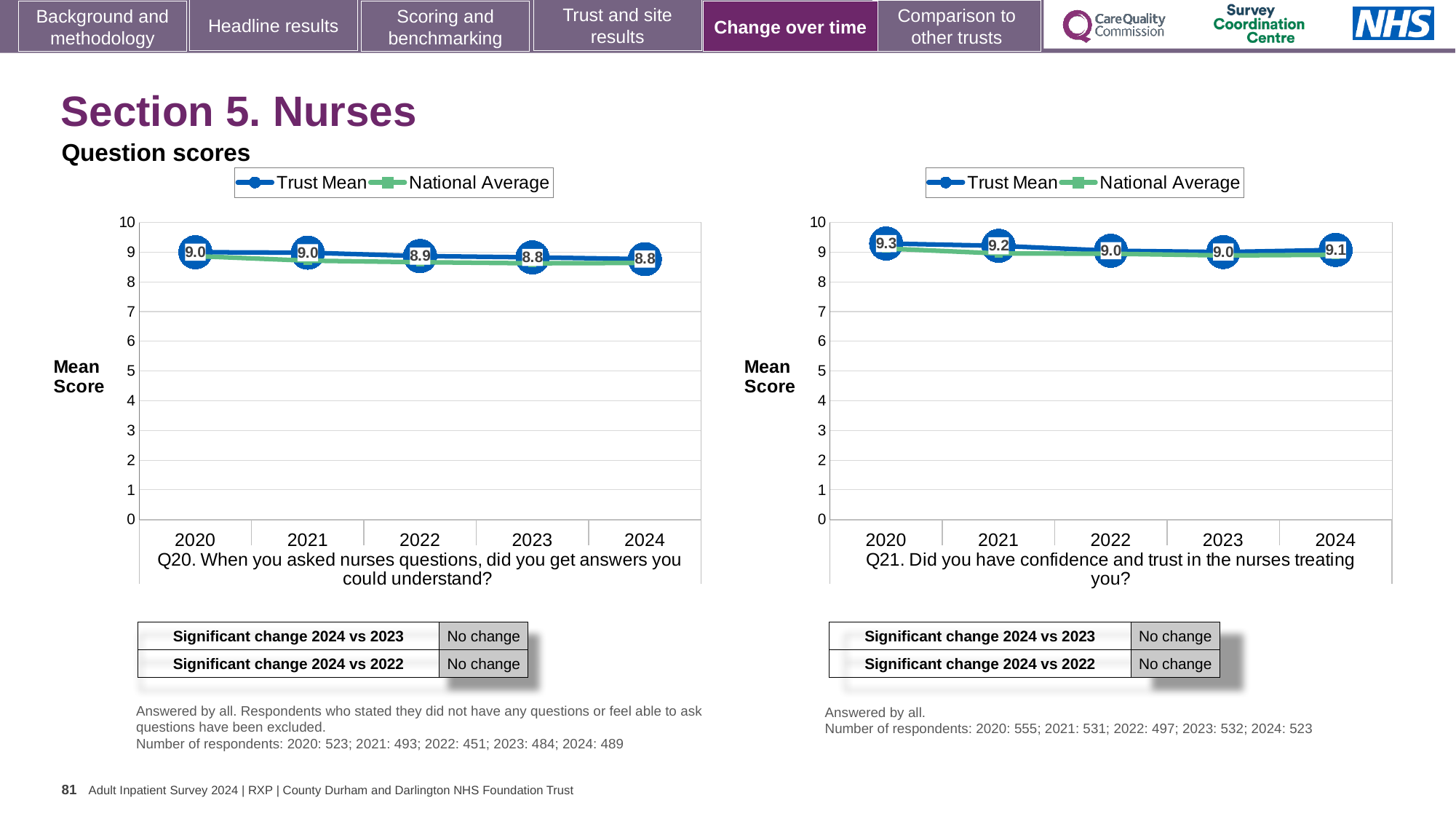
On the Q21 chart (right), which year has the highest Trust Mean score? 2020 On the Q20 chart (left), what is the Trust Mean score for 2020? 9.0 On the Q20 chart (left), what is the difference between the Trust Mean score in 2020 and in 2024? 0.2 Is the Trust Mean score for 2024 on the Q21 chart (right) larger than the Trust Mean score for 2024 on the Q20 chart (left)? Yes On the Q20 chart (left), is the National Average value for 2024 greater or less than 8? greater What type of chart is used for Q20 (left)? Line chart How many series does the legend of the Q21 chart (right) list? 2 How many years are plotted on the Q20 chart (left)? 5 On the Q20 chart (left), what is the Trust Mean score for 2024? 8.8 On the Q21 chart (right), what is the Trust Mean score for 2024? 9.1 On the Q21 chart (right), what is the Trust Mean score for 2020? 9.3 On the Q21 chart (right), what is the difference between the Trust Mean score in 2020 and in 2022? 0.3